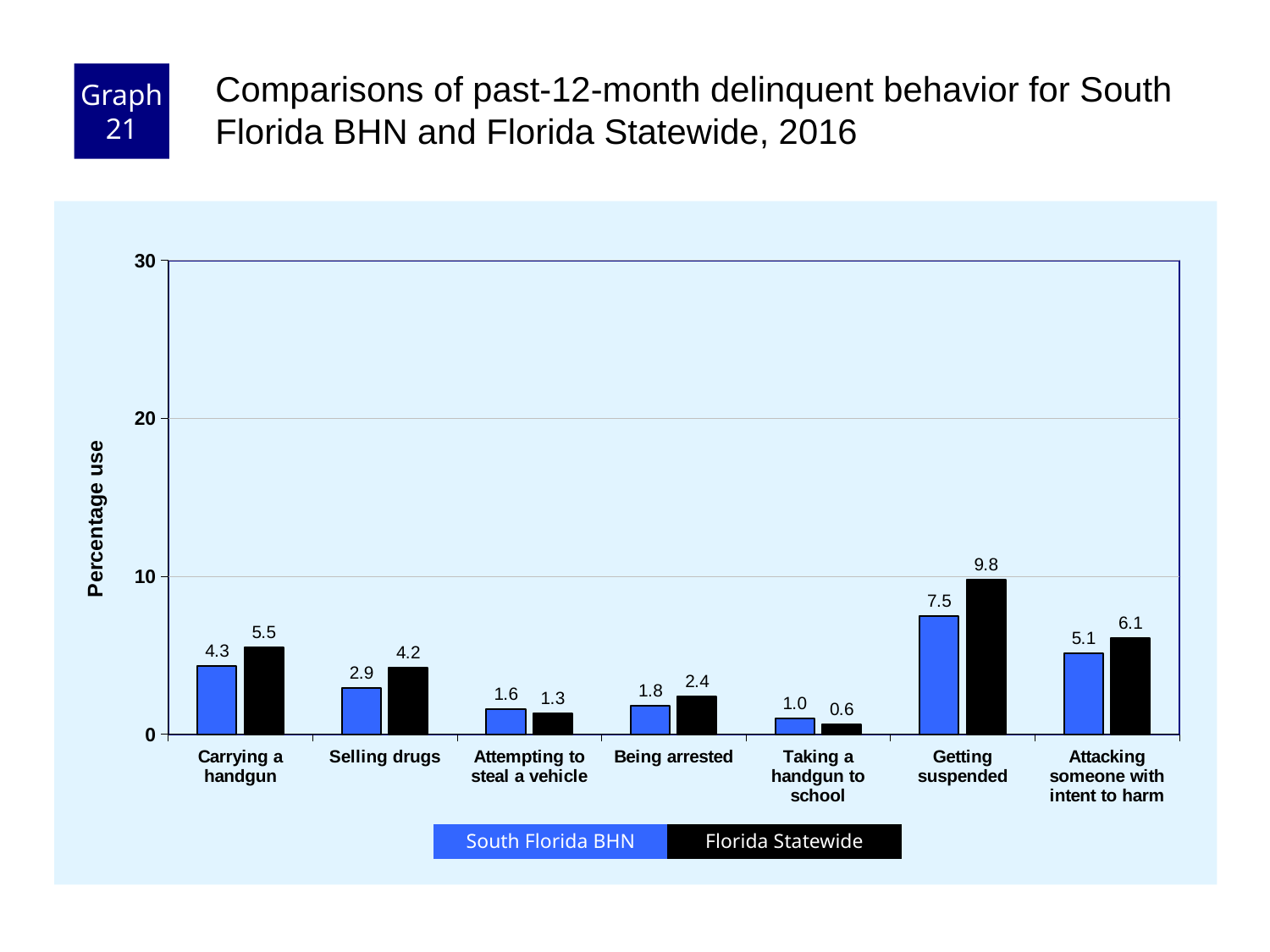
Is the Florida Statewide value for Getting suspended greater or less than 10? less Which category has the highest Florida Statewide value? Getting suspended What kind of chart is shown on the slide? bar chart Which is larger for Attempting to steal a vehicle: South Florida BHN or Florida Statewide? South Florida BHN How many categories are shown on the x axis? 7 Which category has the lowest South Florida BHN value? Taking a handgun to school What is the difference between the Florida Statewide and South Florida BHN values for Selling drugs? 1.3 What is the Florida Statewide value for Carrying a handgun? 5.5 What is the South Florida BHN value for Taking a handgun to school? 1.0 What is the difference between the Florida Statewide and South Florida BHN values for Getting suspended? 2.3 How many series does the legend list? 2 What is the South Florida BHN value for Getting suspended? 7.5